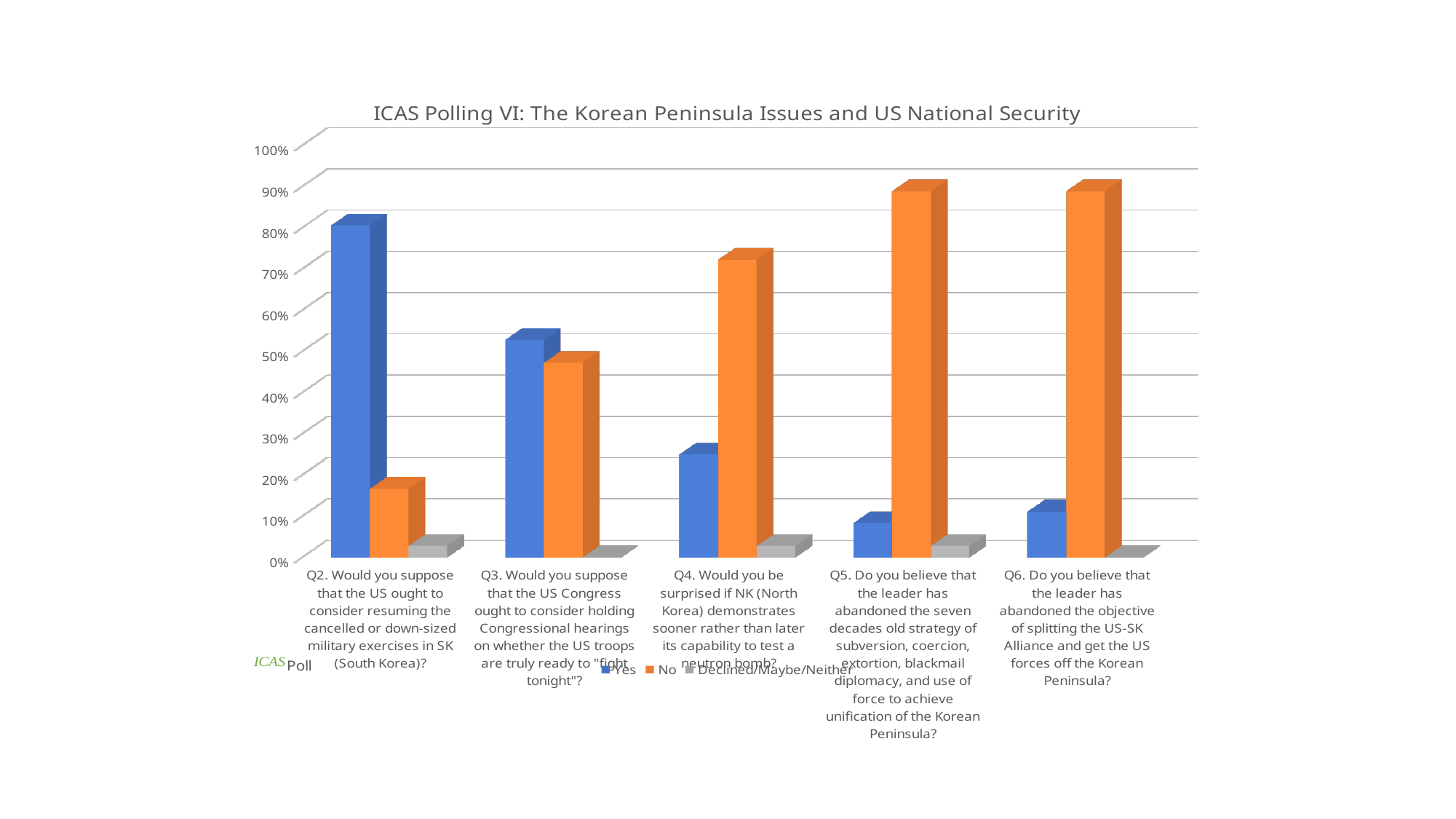
Is the Yes value for Q2 greater or less than 70%? greater Which poll question has the highest Yes value? Q2 Is the Yes value for Q5 greater or less than 20%? less Which series is shown in orange? No How many poll questions (categories) are plotted on the x axis? 5 Is the No value for Q4 greater or less than 60%? greater What kind of chart is shown on the slide? bar chart How many series does the legend list? 3 What is the title of the chart? ICAS Polling VI: The Korean Peninsula Issues and US National Security For Q4, which is larger, the Yes value or the No value? No